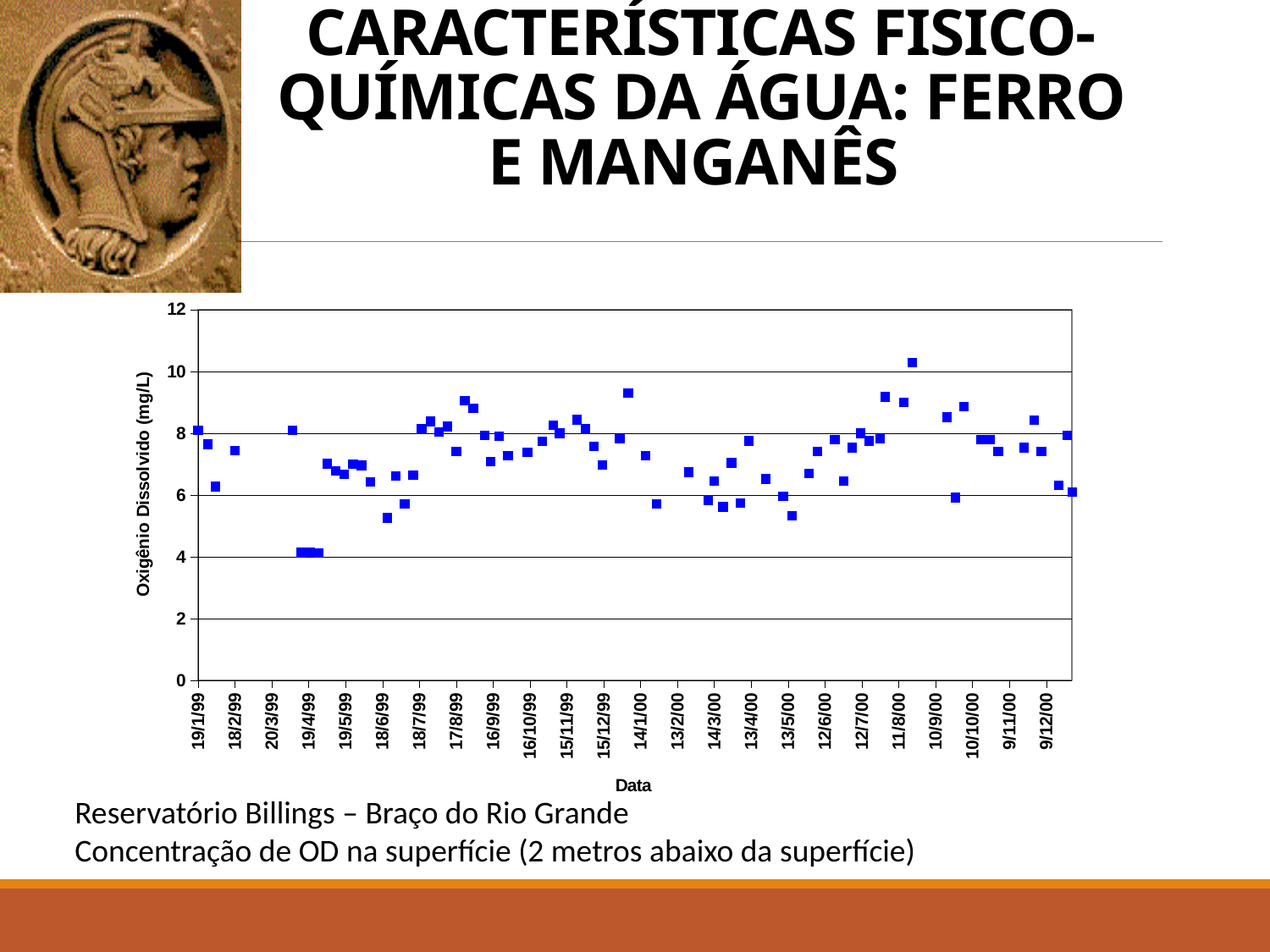
What is the title of the vertical axis of the chart? Oxigênio Dissolvido (mg/L) What is the title of the horizontal axis of the chart? Data What kind of chart is shown on the slide? scatter chart Is the dissolved oxygen value plotted at 18/6/99 greater or less than 6? less Is the dissolved oxygen value plotted at 13/5/00 greater or less than 6? less Is the highest dissolved oxygen value plotted near 11/8/00 greater or less than 10? greater Which is larger, the dissolved oxygen value plotted at 14/1/00 or the value plotted at 19/4/99? 14/1/00 Around which date on the x axis does the chart reach its highest dissolved oxygen value? 11/8/00 What is the maximum value shown on the vertical axis of the chart? 12 Around which date on the x axis does the chart show its lowest dissolved oxygen values? 19/4/99